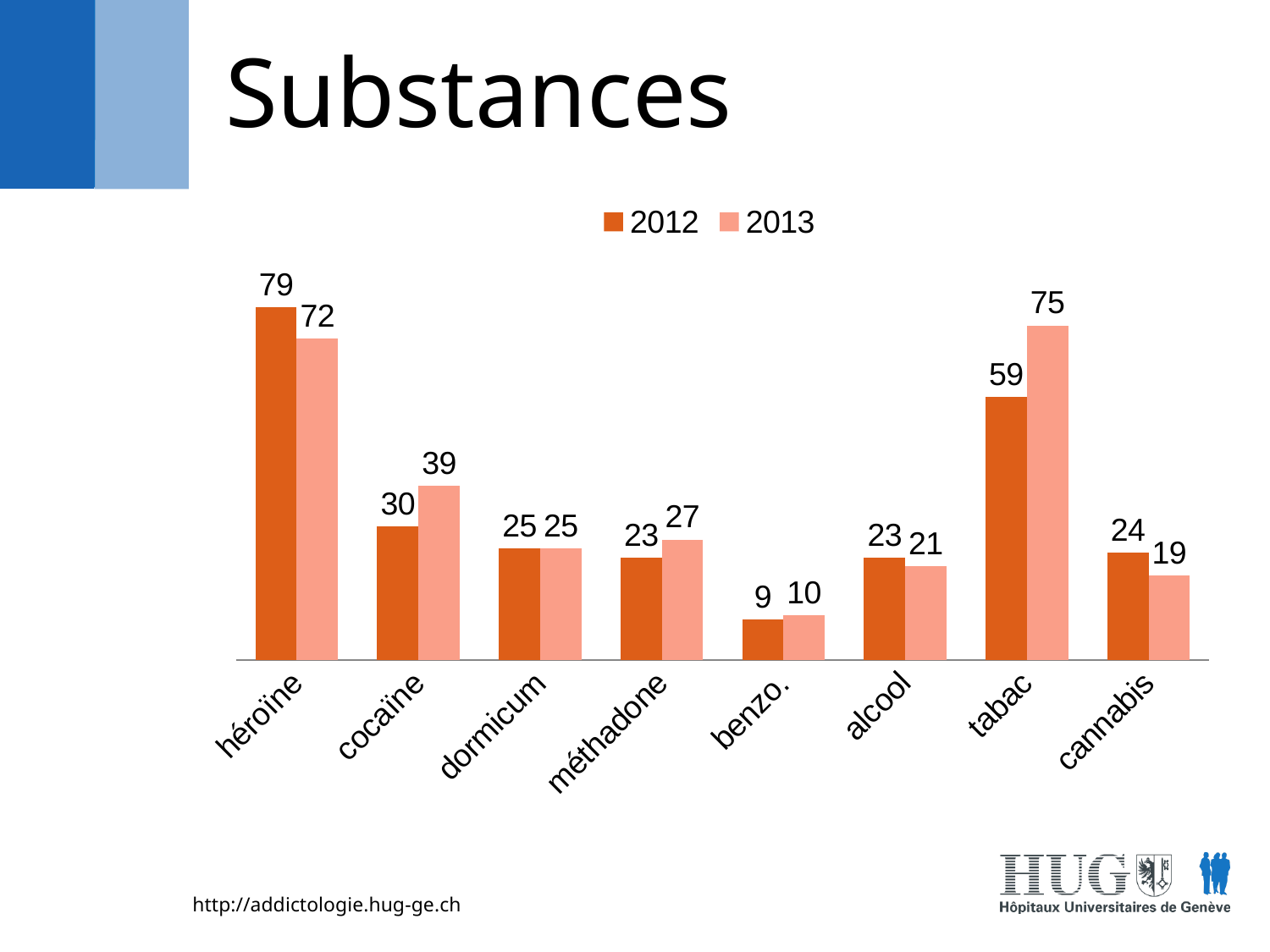
Which substance has the lowest value in 2013? benzo. What is the title of the slide containing the chart? Substances What kind of chart is shown on the slide? bar chart What is the difference between the 2012 and 2013 values for héroïne? 7 How many series does the legend list? 2 Which substance has the highest value in 2012? héroïne What is the difference between the 2013 and 2012 values for tabac? 16 What is the value for tabac in 2013? 75 How many substances are shown on the x axis? 8 What is the value for héroïne in 2012? 79 Which is larger for cannabis, the 2012 value or the 2013 value? 2012 What is the value for cocaïne in 2013? 39